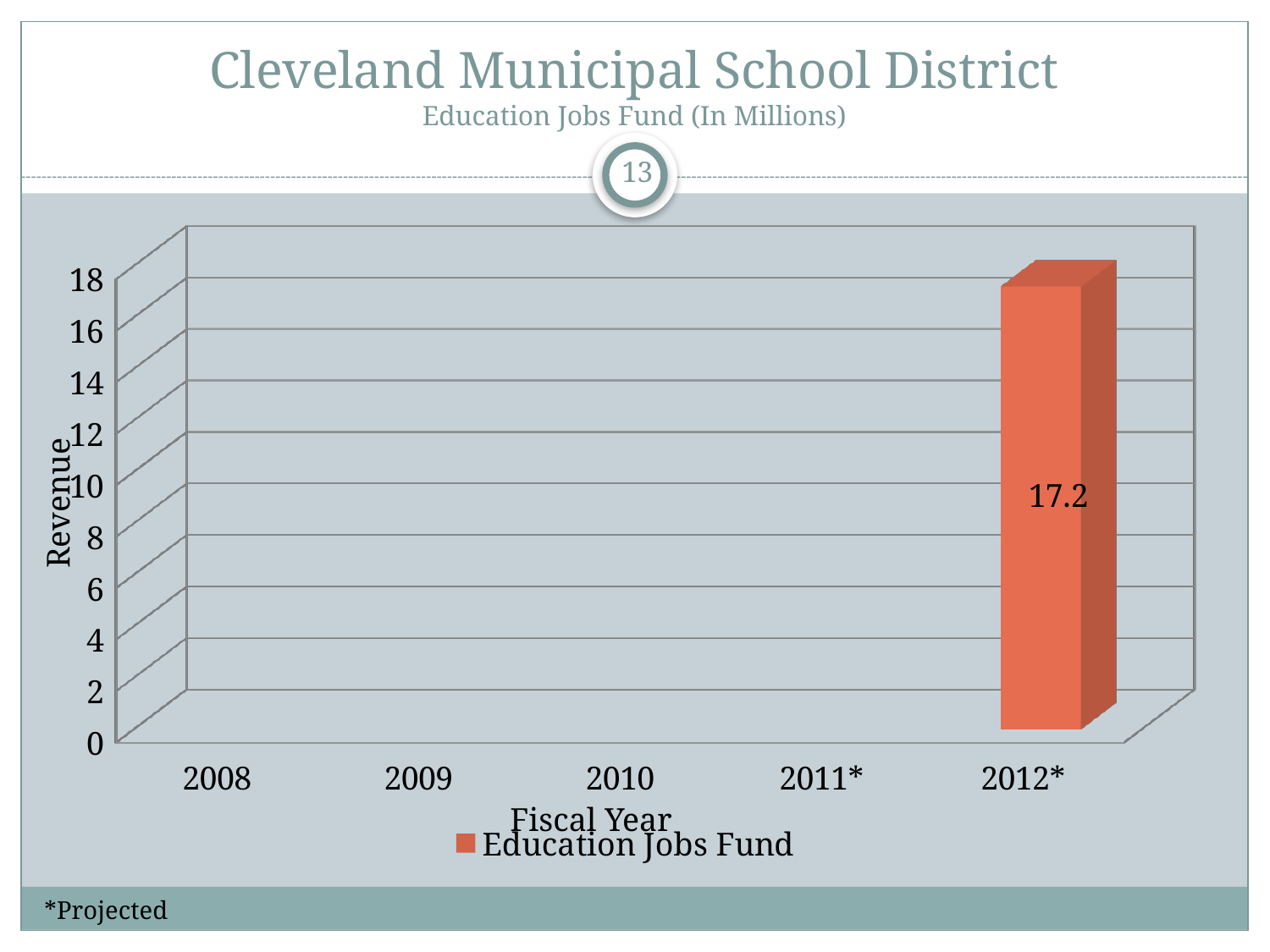
Is the value for 2012* greater or less than 18? less Is the value for 2012* greater or less than 16? greater How many fiscal years are shown on the x axis? 5 Which fiscal year has the highest Education Jobs Fund value? 2012* How many series does the legend list? 1 Which fiscal years have no bar plotted? 2008, 2009, 2010, 2011* What is the label of the x axis? Fiscal Year What is the name of the series shown in the legend? Education Jobs Fund What is the value of the Education Jobs Fund for fiscal year 2012*? 17.2 What kind of chart is shown on the slide? bar chart What is the label of the y axis? Revenue